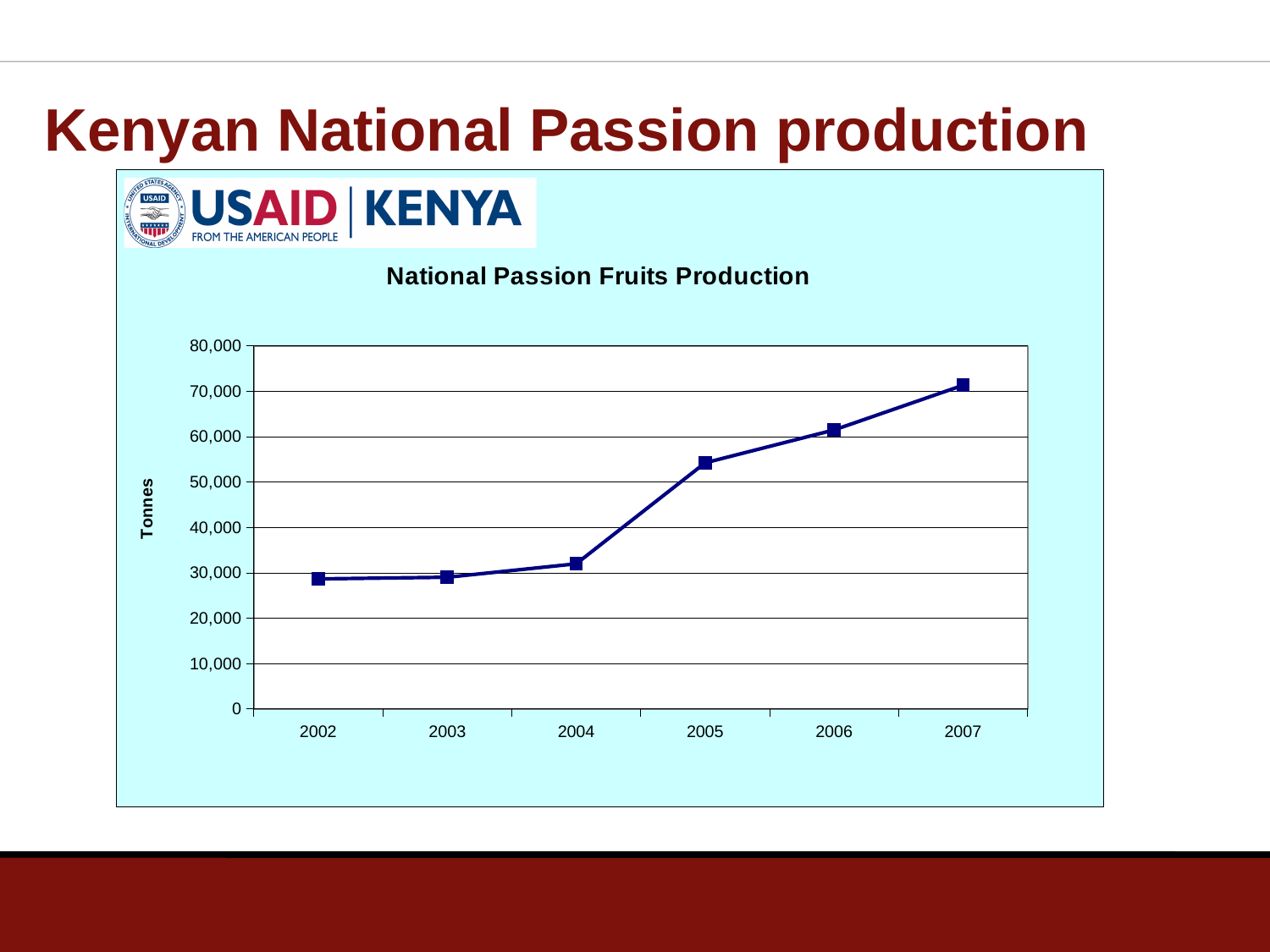
Is the production value for 2007 greater or less than 60,000? greater What is the title of the chart? National Passion Fruits Production Do the production values generally rise or fall from 2002 to 2007? rise Is the production value for 2004 greater or less than 40,000? less Which year has the highest production on the chart? 2007 What is the label on the vertical axis of the chart? Tonnes How many years are plotted on the chart? 6 Is the production value for 2006 greater or less than 50,000? greater Which year has the larger production value, 2004 or 2005? 2005 What kind of chart is shown on the slide? line chart